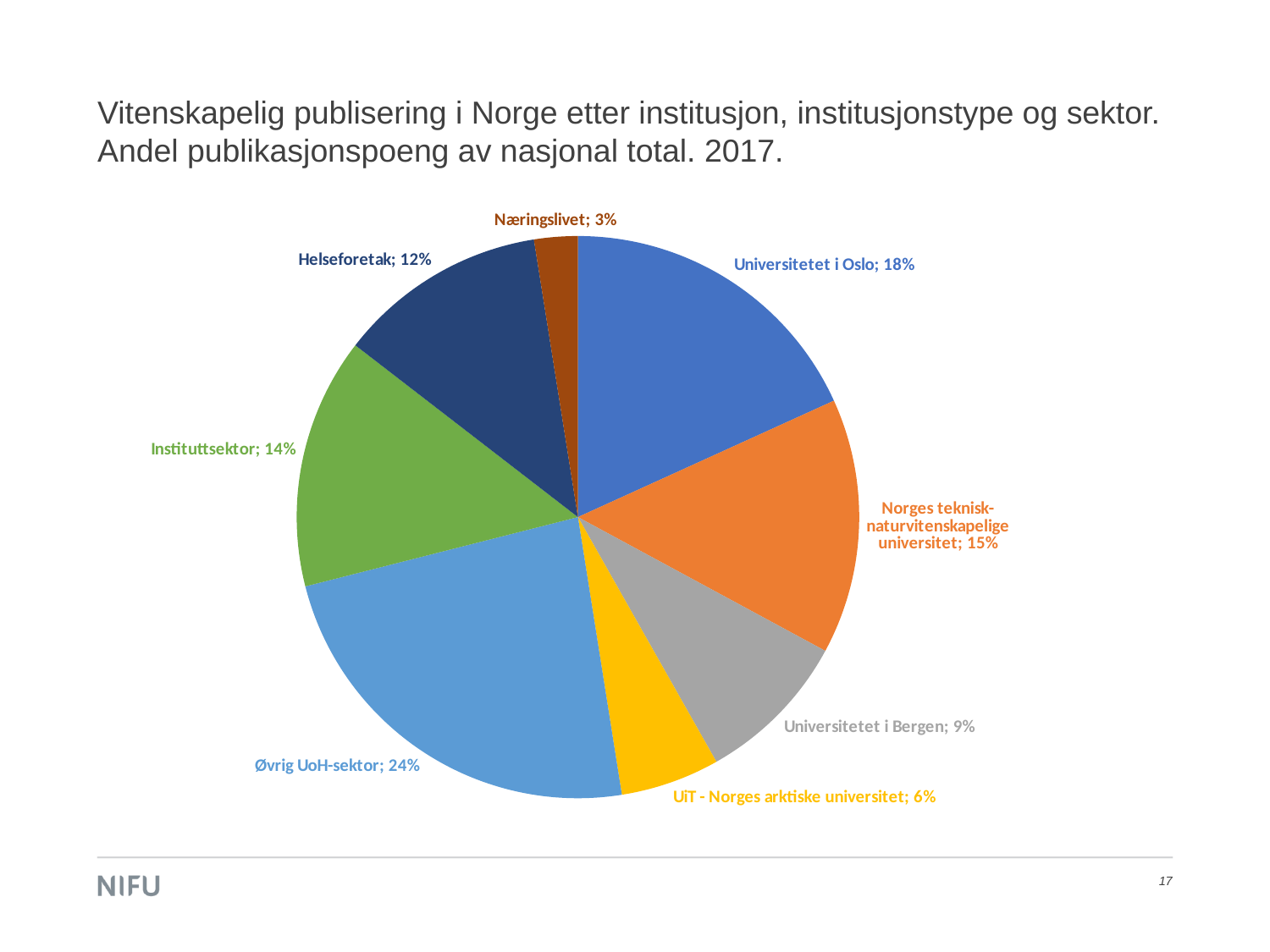
What is the value for UiT - Norges arktiske universitet? 6% Which category has the smallest slice of the pie? Næringslivet What is the value for Øvrig UoH-sektor? 24% What is the value for Helseforetak? 12% Which category has the largest slice of the pie? Øvrig UoH-sektor What year does the chart title refer to? 2017 What share of the pie does Universitetet i Oslo have? 18% What kind of chart is shown on the slide? pie chart What is the difference between the shares of Universitetet i Oslo and Universitetet i Bergen? 9% How many slices does the pie chart have? 8 Which is larger, the share for Instituttsektor or the share for Helseforetak? Instituttsektor What is the value for Norges teknisk-naturvitenskapelige universitet? 15%